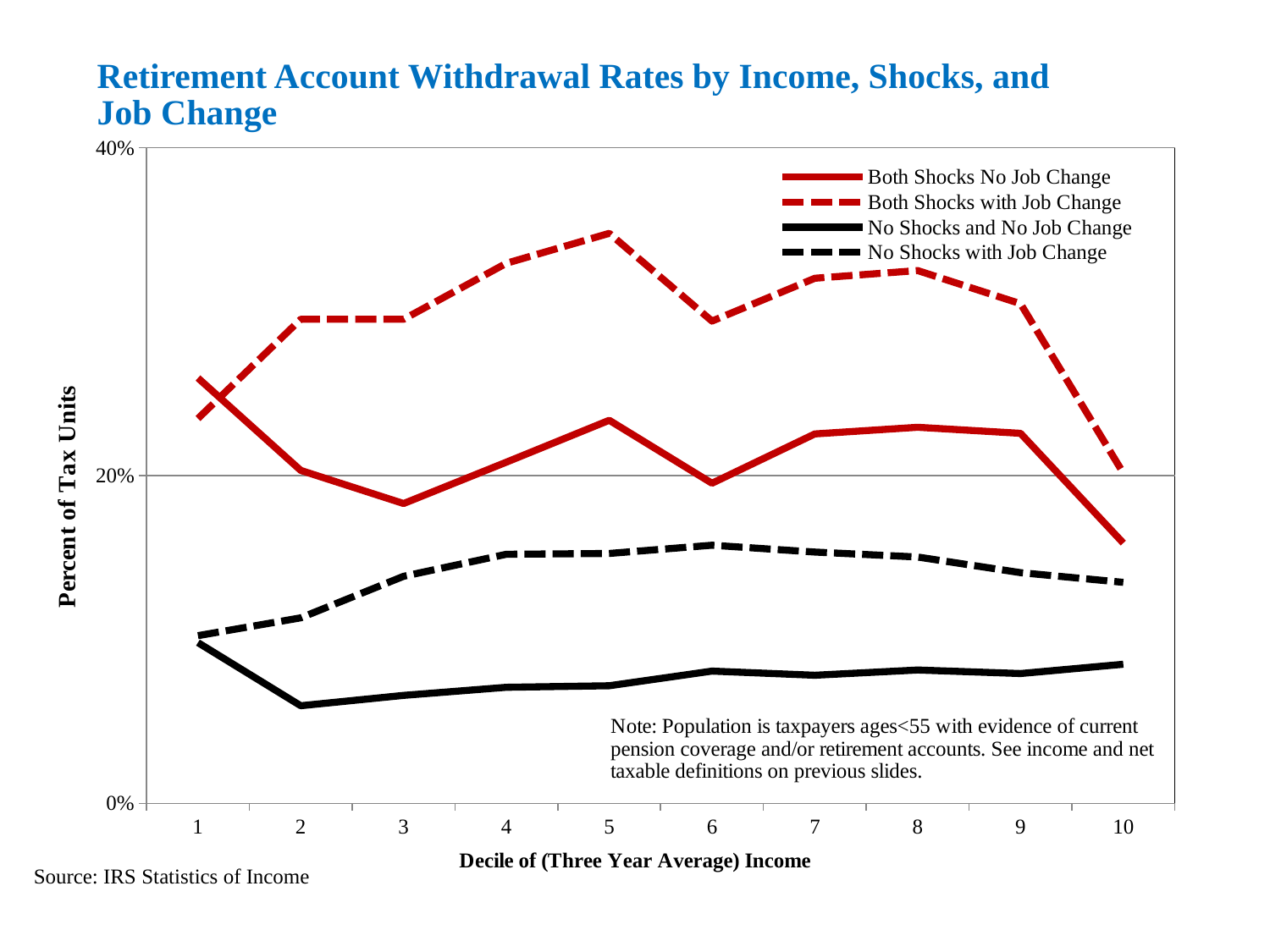
Which series has the highest withdrawal rates across the deciles? Both Shocks with Job Change At decile 10, which is larger: Both Shocks with Job Change or Both Shocks No Job Change? Both Shocks with Job Change At which decile does the No Shocks and No Job Change series reach its lowest value? 2 Does the Both Shocks with Job Change series rise or fall from decile 9 to decile 10? fall Is the value for No Shocks and No Job Change at decile 2 greater or less than 20%? less How many series does the legend list? 4 Which series has the lowest withdrawal rates across the deciles? No Shocks and No Job Change How many income deciles are plotted along the x axis? 10 What is the label of the y axis? Percent of Tax Units Is the value for Both Shocks No Job Change at decile 10 greater or less than 20%? less Is the value for Both Shocks with Job Change at decile 5 greater or less than 20%? greater What kind of chart is shown on the slide? line chart